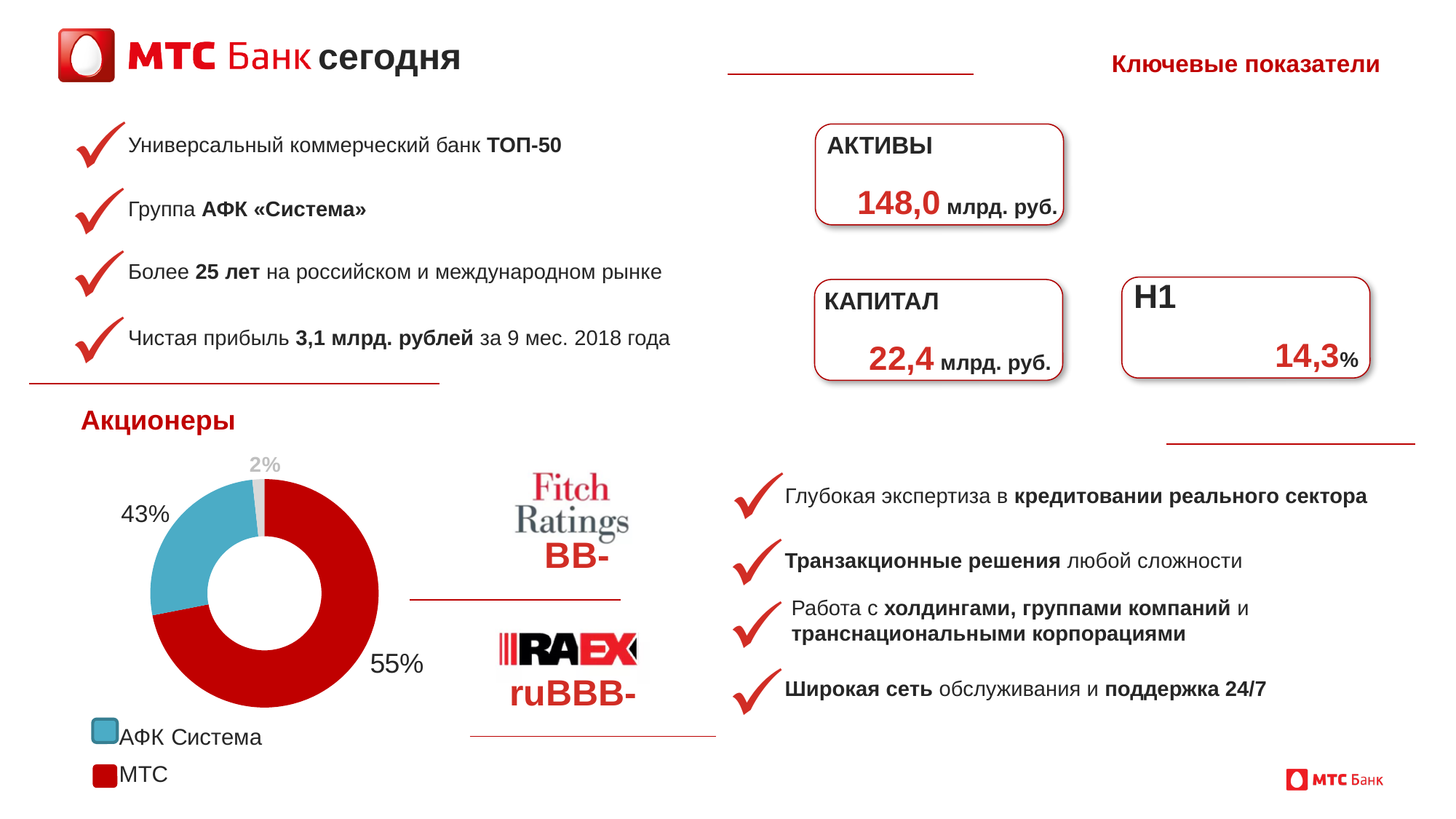
What is the smallest percentage shown on the Акционеры chart? 2% How many entries does the legend of the Акционеры chart list? 2 What do the three labelled slices of the Акционеры chart add up to? 100% What share of the Акционеры chart does МТС hold? 55% How many slices does the Акционеры chart have? 3 Which is larger in the Акционеры chart, the МТС slice or the АФК Система slice? МТС Which shareholder has the largest slice in the Акционеры chart? МТС By how many percentage points does the МТС share exceed the АФК Система share in the Акционеры chart? 12% What share of the Акционеры chart does АФК Система hold? 43% What is the title of the chart on the slide? Акционеры What colour is the МТС slice in the Акционеры chart? red What type of chart is the Акционеры chart? doughnut chart